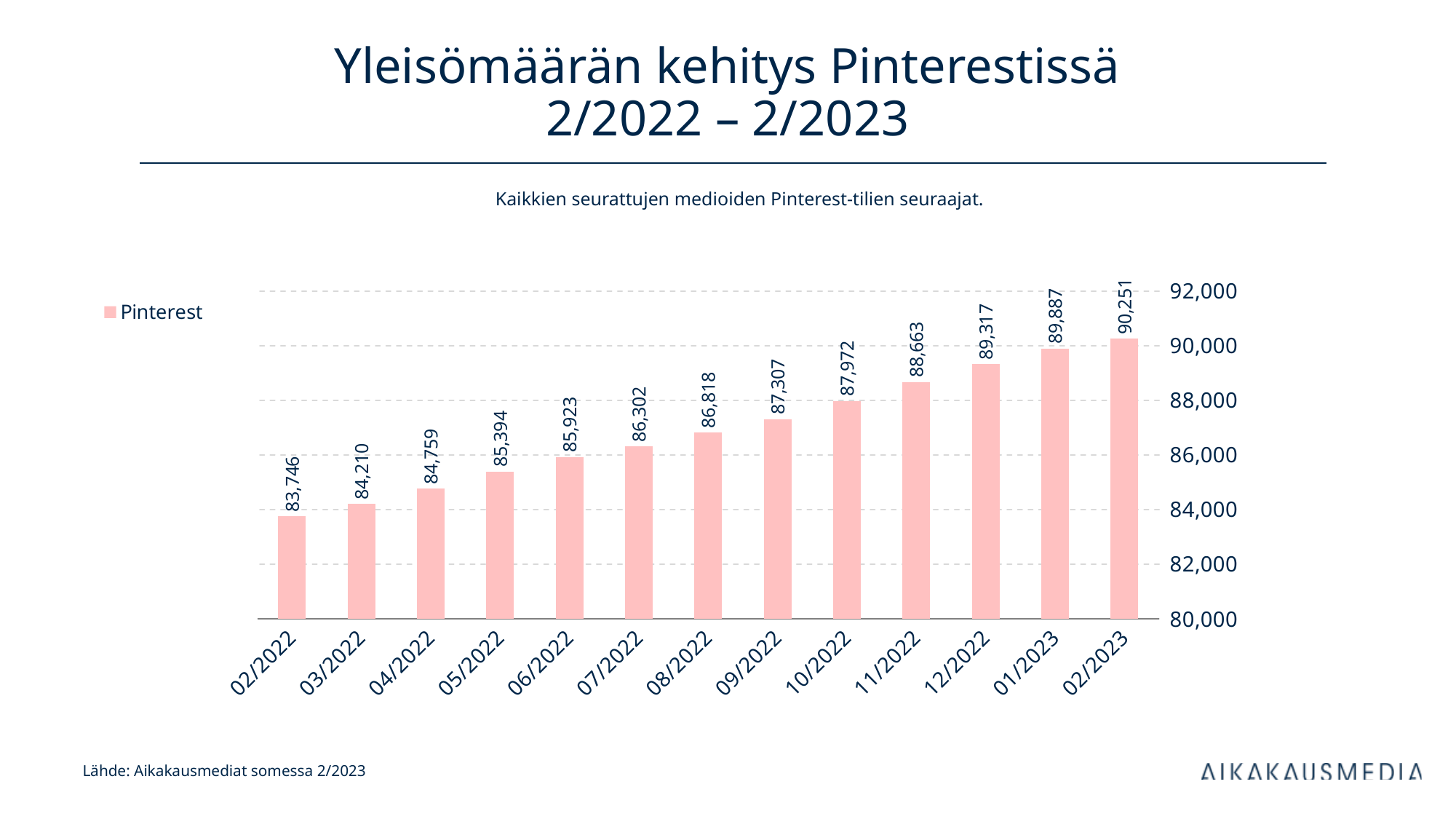
What kind of chart is shown on the slide? bar chart What is the difference between the values for 02/2023 and 02/2022? 6,505 Which month has the lowest value? 02/2022 How many months are shown on the x axis? 13 What is the value shown for 01/2023? 89,887 What is the value shown for 09/2022? 87,307 Which month has the highest value? 02/2023 What is the Pinterest follower count for 02/2022? 83,746 Which is larger, the value for 06/2022 or the value for 10/2022? 10/2022 Is the value for 08/2022 greater or less than 88,000? less Do the values rise or fall from 02/2022 to 02/2023? rise What is the difference between the values for 12/2022 and 11/2022? 654